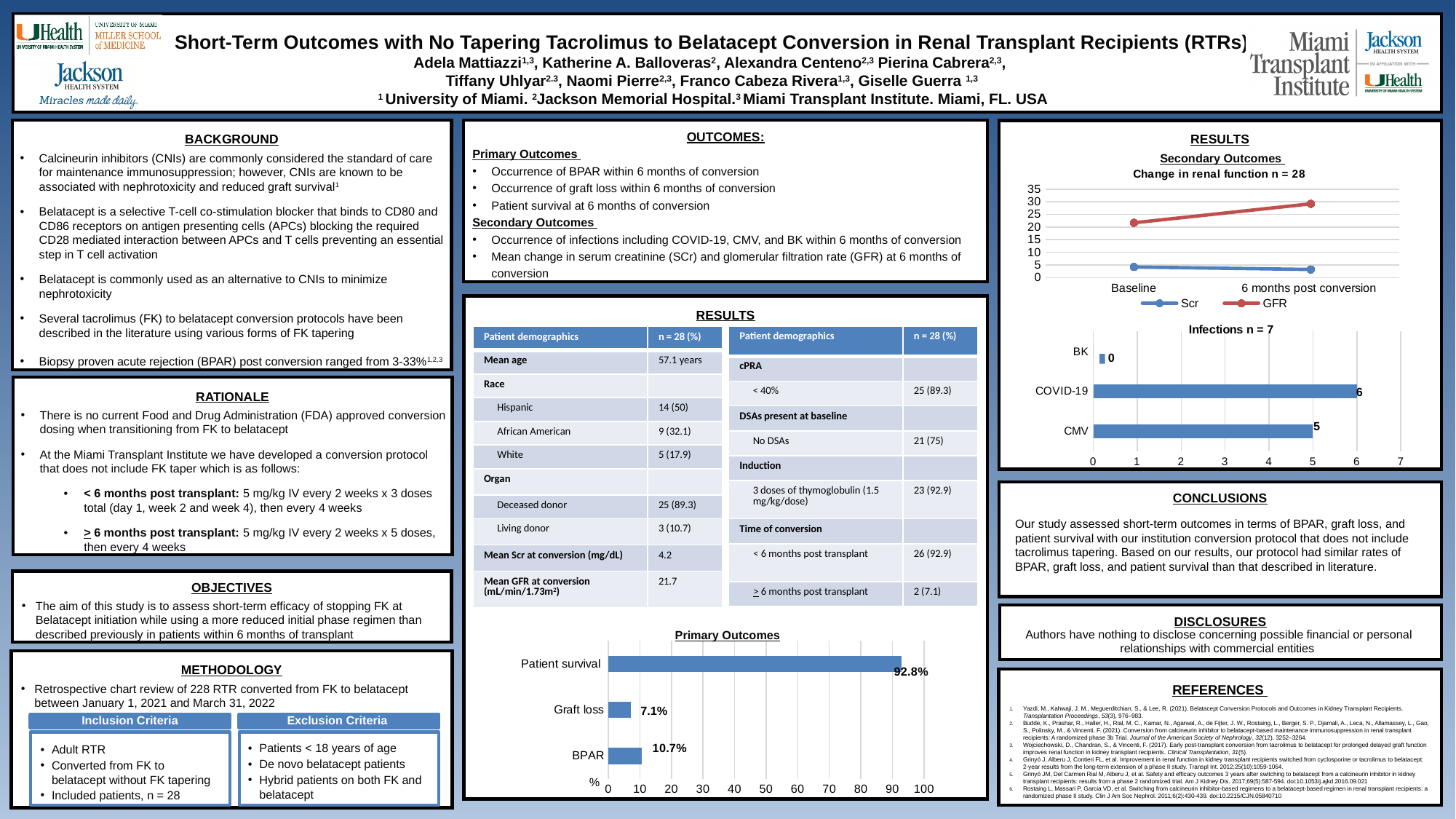
In the 'Infections n = 7' chart, which is larger, the value for CMV or the value for COVID-19? COVID-19 In the 'Primary Outcomes' chart, what is the value for BPAR? 10.7% In the 'Primary Outcomes' chart, which category has the lowest value? Graft loss In the 'Primary Outcomes' chart, what is the value for Patient survival? 92.8% In the 'Change in renal function n = 28' chart, how many series does the legend list? 2 In the 'Primary Outcomes' chart, how many categories are shown? 3 In the 'Primary Outcomes' chart, what is the difference between the BPAR value and the Graft loss value? 3.6% In the 'Infections n = 7' chart, what is the value for COVID-19? 6 In the 'Infections n = 7' chart, which category has the highest value? COVID-19 In the 'Infections n = 7' chart, what is the value for BK? 0 In the 'Change in renal function n = 28' chart, is the GFR value at 6 months post conversion greater or less than 25? greater In the 'Change in renal function n = 28' chart, does the GFR series rise or fall from Baseline to 6 months post conversion? rise